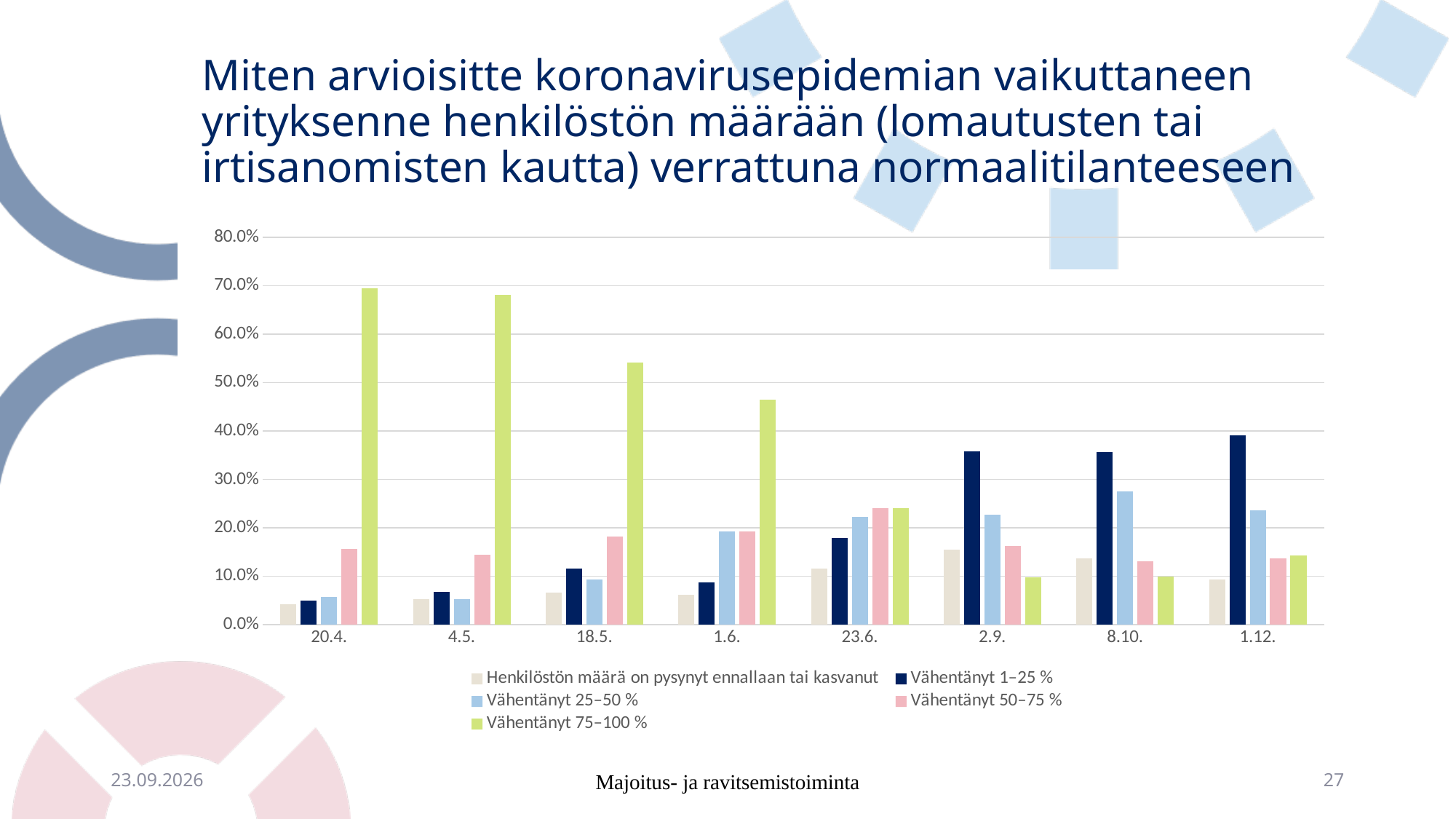
What kind of chart is shown on the slide? bar chart Is the value for 'Vähentänyt 1–25 %' on 1.12. greater or less than 30.0%? greater How many series does the legend list? 5 Does the 'Vähentänyt 75–100 %' series generally rise or fall from 20.4. to 8.10.? fall Is the value for 'Vähentänyt 75–100 %' on 1.6. greater or less than 40.0%? greater On 8.10., which is larger: 'Vähentänyt 25–50 %' or 'Vähentänyt 50–75 %'? Vähentänyt 25–50 % On which date is the 'Vähentänyt 1–25 %' series at its highest? 1.12. Is the value for 'Henkilöstön määrä on pysynyt ennallaan tai kasvanut' on 20.4. greater or less than 10.0%? less How many dates (categories) are shown on the x axis? 8 On which date is the 'Vähentänyt 1–25 %' series at its lowest? 20.4. On 23.6., which is larger: 'Vähentänyt 75–100 %' or 'Vähentänyt 1–25 %'? Vähentänyt 75–100 %